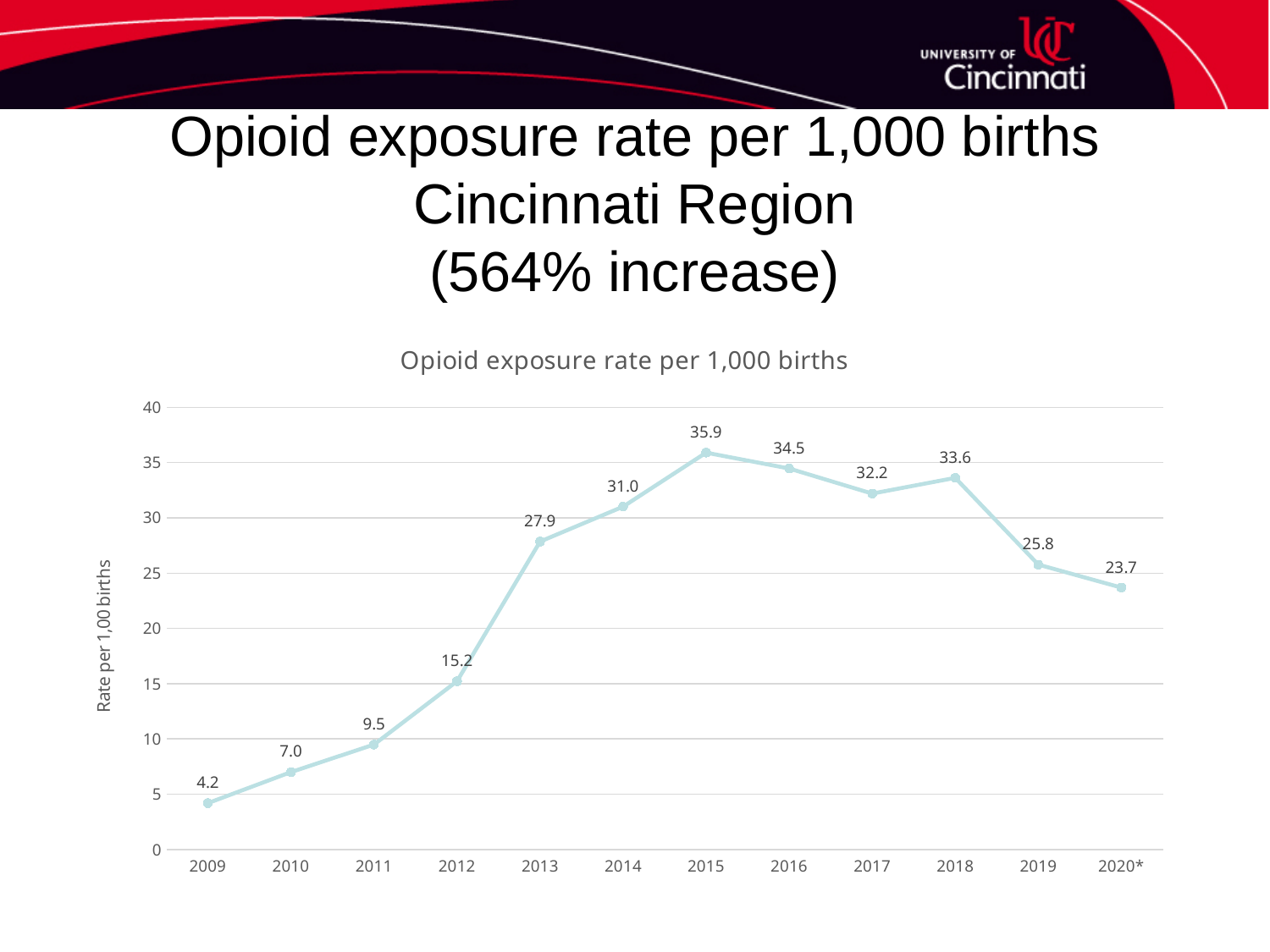
Which year has the lowest opioid exposure rate? 2009 What is the opioid exposure rate per 1,000 births in 2020*? 23.7 What kind of chart is shown on the slide? Line chart Which year has a higher opioid exposure rate, 2016 or 2017? 2016 How many years are plotted on the chart? 12 What is the opioid exposure rate per 1,000 births in 2015? 35.9 What is the difference between the opioid exposure rate in 2018 and in 2019? 7.8 Does the opioid exposure rate rise or fall from 2009 to 2015? Rise What is the label on the vertical axis of the chart? Rate per 1,00 births Is the opioid exposure rate in 2013 greater or less than 25? greater Which year has the highest opioid exposure rate? 2015 What is the opioid exposure rate per 1,000 births in 2009? 4.2